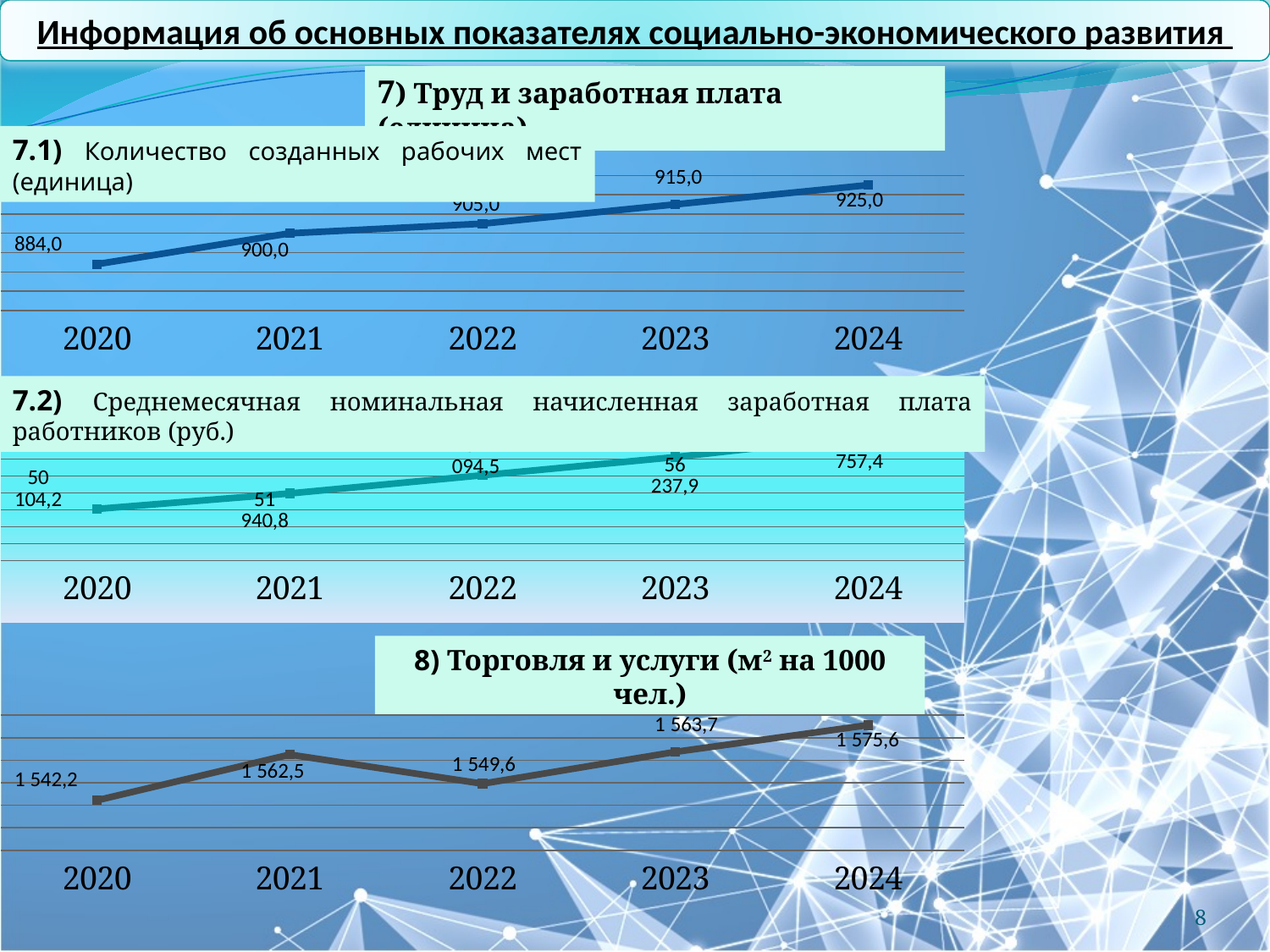
In the chart 7.1 (Количество созданных рабочих мест), what is the value for 2024? 925,0 In the chart 7.2 (Среднемесячная номинальная начисленная заработная плата), how many years are plotted? 5 In the chart 8 (Торговля и услуги), what is the value for 2022? 1 549,6 In the chart 8 (Торговля и услуги), which year has the lowest value? 2020 In the chart 7.1 (Количество созданных рабочих мест), what is the difference between the 2024 and 2020 values? 41,0 In the chart 8 (Торговля и услуги), which is larger, the value for 2021 or the value for 2022? 2021 In the chart 7.1 (Количество созданных рабочих мест), what is the value for 2020? 884,0 In the chart 7.1 (Количество созданных рабочих мест), which year has the highest value? 2024 In the chart 7.2 (Среднемесячная номинальная начисленная заработная плата), do the values rise or fall from 2020 to 2024? rise In the chart 7.1 (Количество созданных рабочих мест), do the values rise or fall from 2020 to 2024? rise In the chart 8 (Торговля и услуги), what is the value for 2024? 1 575,6 What kind of chart is the chart 8 (Торговля и услуги)? line chart